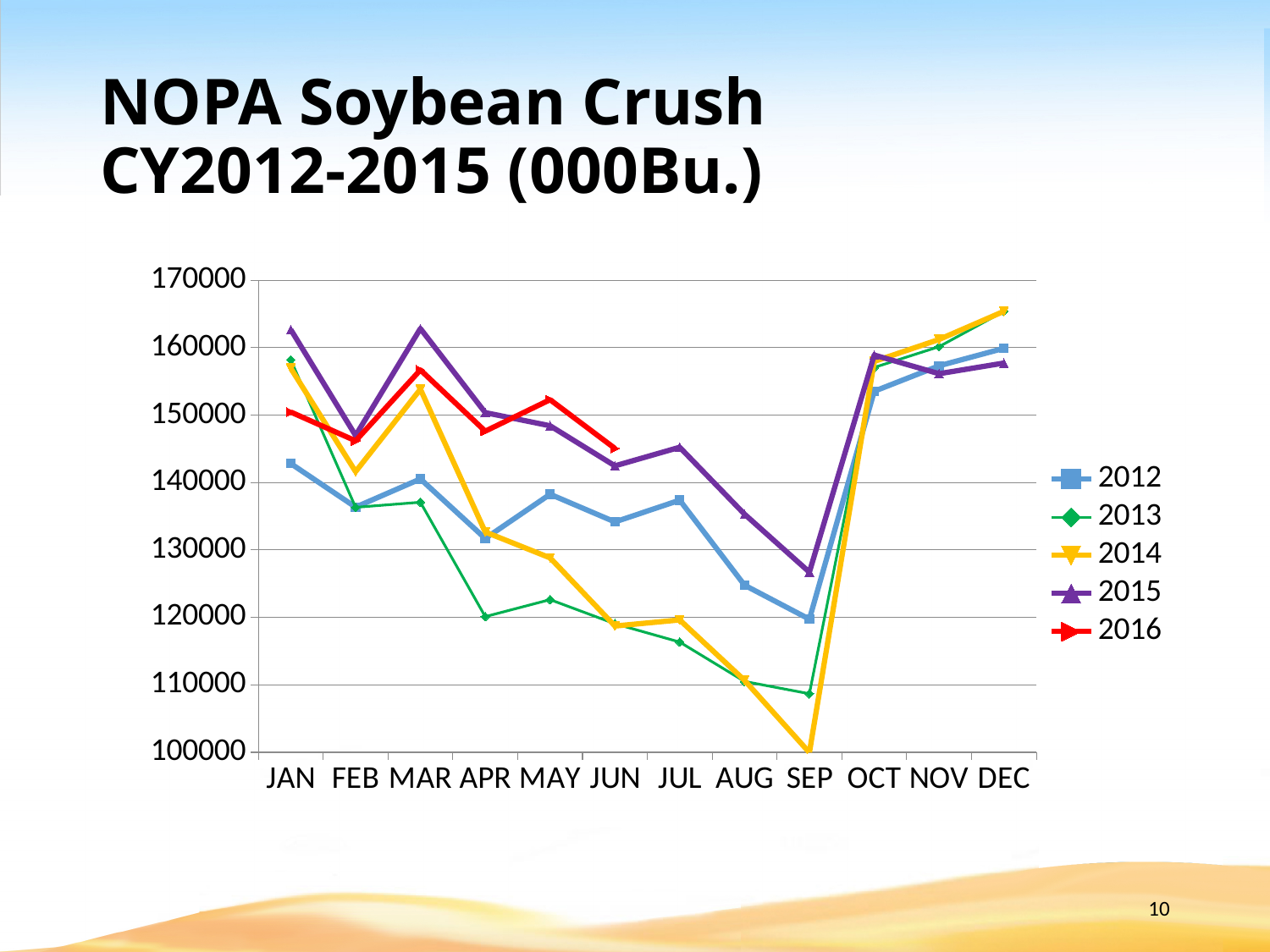
Which series has the highest value in SEP? 2015 Does the 2016 series rise or fall from JAN to FEB? fall Is the value for 2015 in MAR greater or less than 160000? greater Is the value for 2012 in AUG greater or less than 130000? less In which month does the 2014 series reach its lowest value? SEP In JAN, which is larger: the value for 2015 or the value for 2012? 2015 How many months are shown along the x axis? 12 What kind of chart is shown on the slide? Line chart Is the value for 2014 in SEP greater or less than 110000? less How many series does the legend list? 5 Which series in the legend is plotted only through JUN? 2016 Which series has the highest value in MAR? 2015